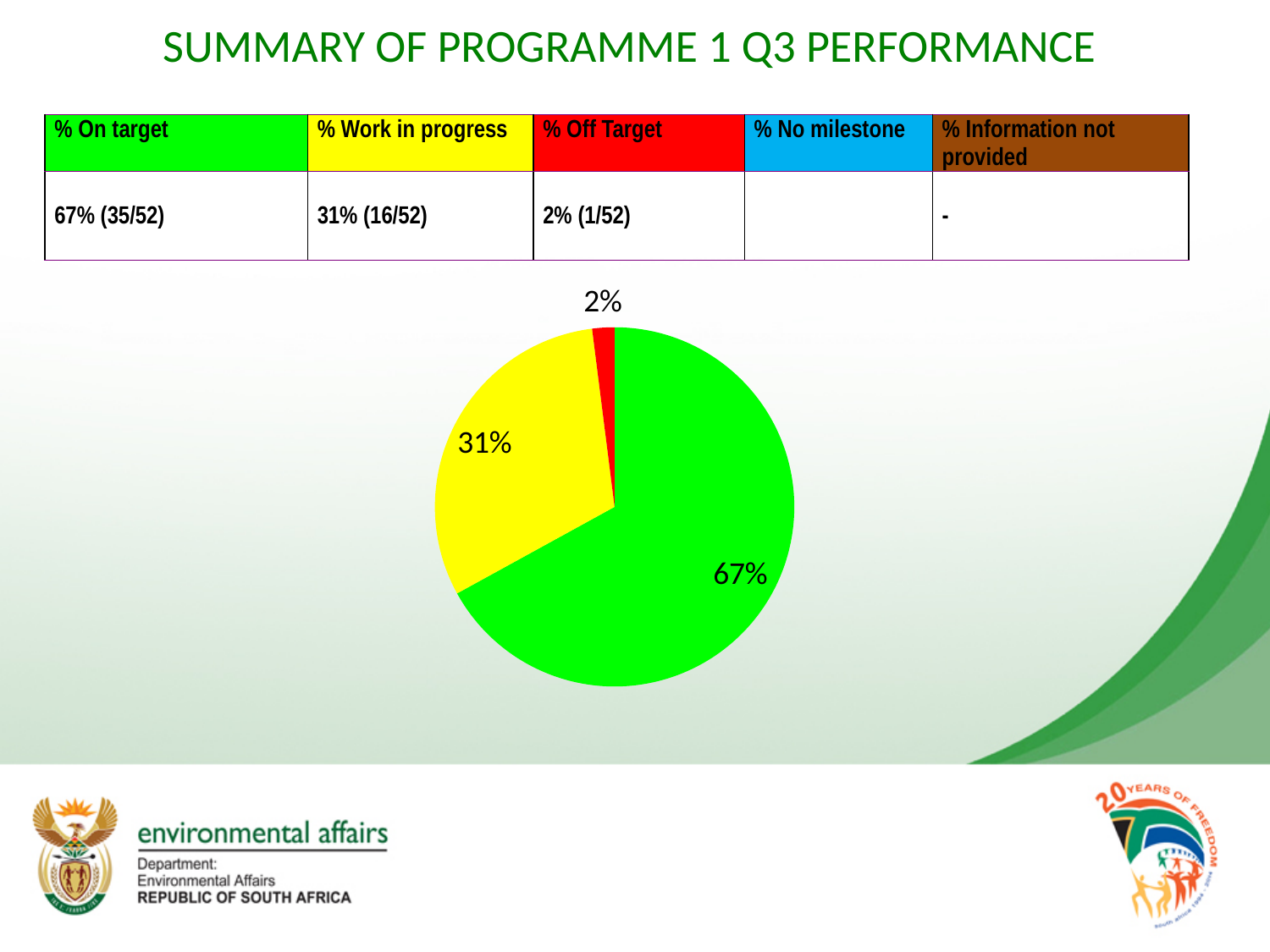
What share of the pie does the yellow slice (Work in progress) represent? 31% What is the difference in percentage points between the On target slice and the Work in progress slice? 36 Which slice of the pie chart is the smallest? 2% (Off Target, red) How many slices does the pie chart have? 3 What share of the pie does the red slice (Off Target) represent? 2% What kind of chart is shown on the slide? pie chart Which slice of the pie chart is the largest? 67% (On target, green) What share of the pie does the green slice (On target) represent? 67% What is the combined share of the Work in progress and Off Target slices? 33% According to the table above the chart, how many of the 52 targets are On target? 35 Which is larger in the pie chart, the Work in progress slice or the Off Target slice? Work in progress (31%) What colour is the slice labelled 31%? yellow